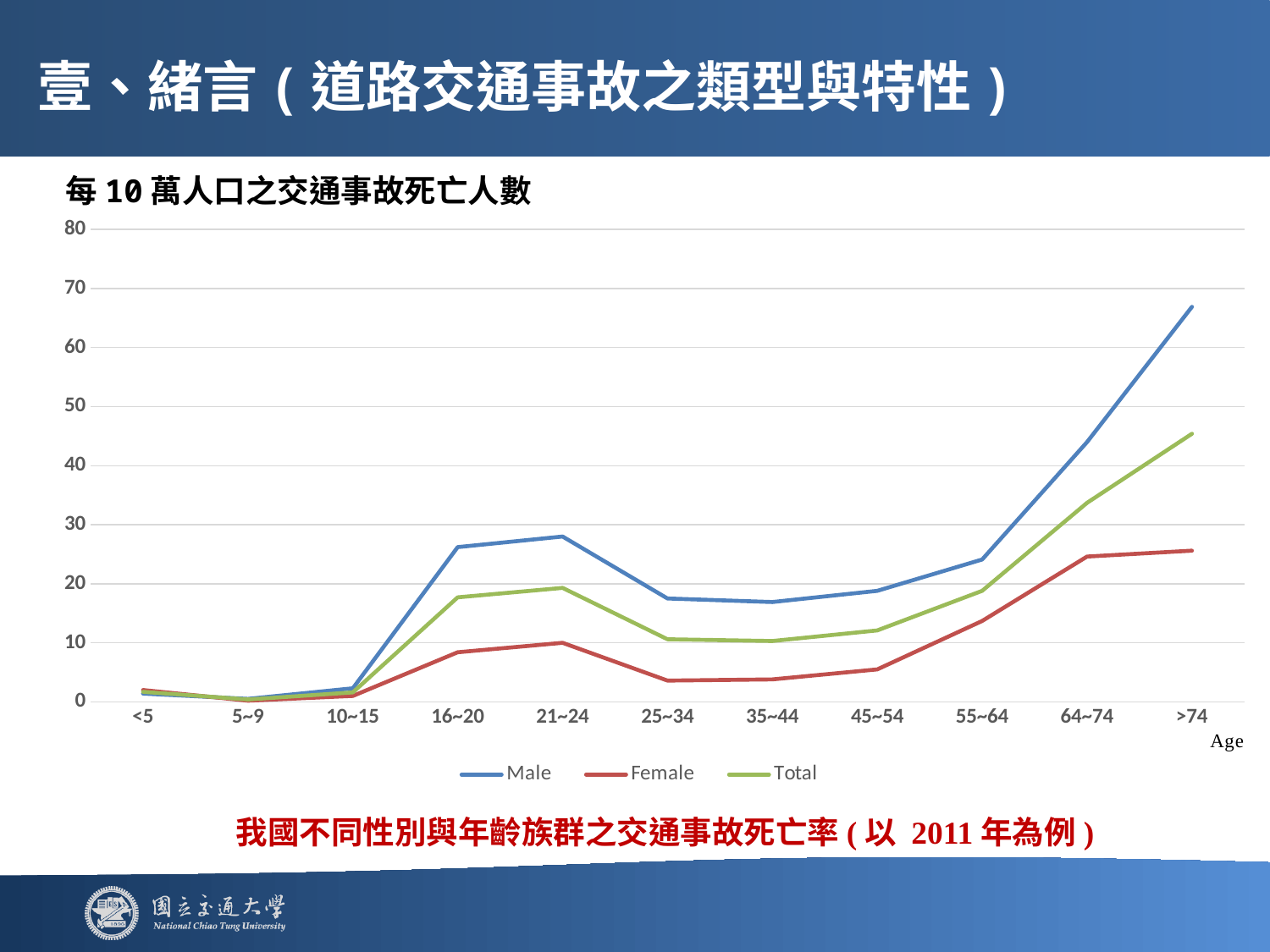
What colour is the line for the Female series? red Which age group has the highest value for the Male series? >74 Is the value for Total at >74 greater or less than 40? greater Is the value for Male at >74 greater or less than 60? greater How many series does the legend list? 3 Which age group has the lowest value for the Male series? 5~9 Which series has the higher value at 21~24, Male or Female? Male Does the Male series rise or fall from 45~54 to >74? rise What kind of chart is shown on the slide? line chart How many age groups are shown on the x axis? 11 Is the value for Female at >74 greater or less than 20? greater